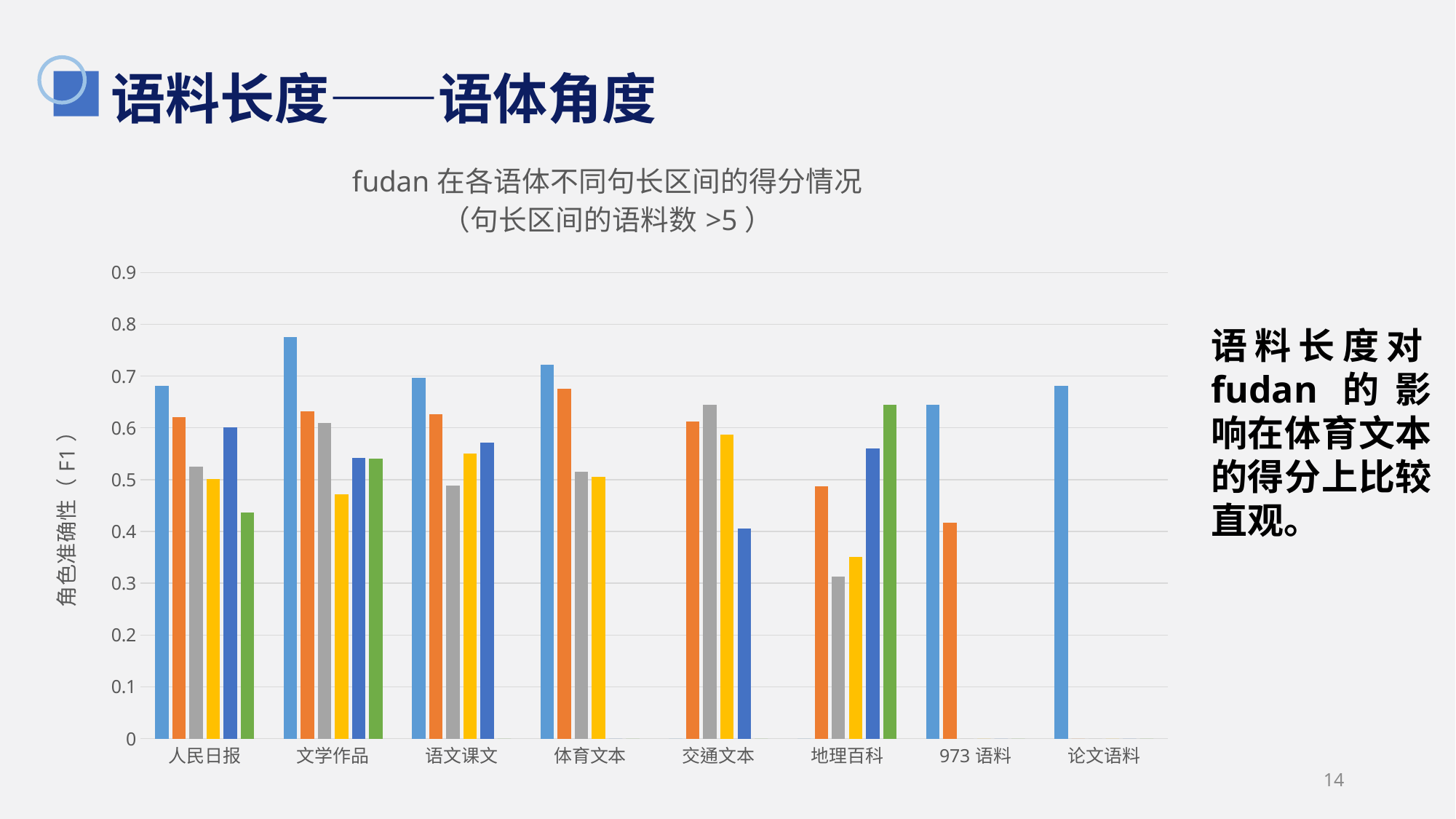
Which is larger: the light blue bar for 文学作品 or the light blue bar for 人民日报? 文学作品 Is the value of the yellow bar for 地理百科 greater or less than 0.4? less How many bars are plotted for the category 论文语料? 1 Is the value of the light blue bar for 论文语料 greater or less than 0.7? less Is the value of the orange bar for 973 语料 greater or less than 0.5? less What is the label of the vertical axis of the chart? 角色准确性（F1） Which category has the tallest light blue (first) bar? 文学作品 What is the title of the chart? fudan 在各语体不同句长区间的得分情况（句长区间的语料数 >5） What kind of chart is shown on the slide? bar chart How many categories (语体) are shown along the x axis of the chart? 8